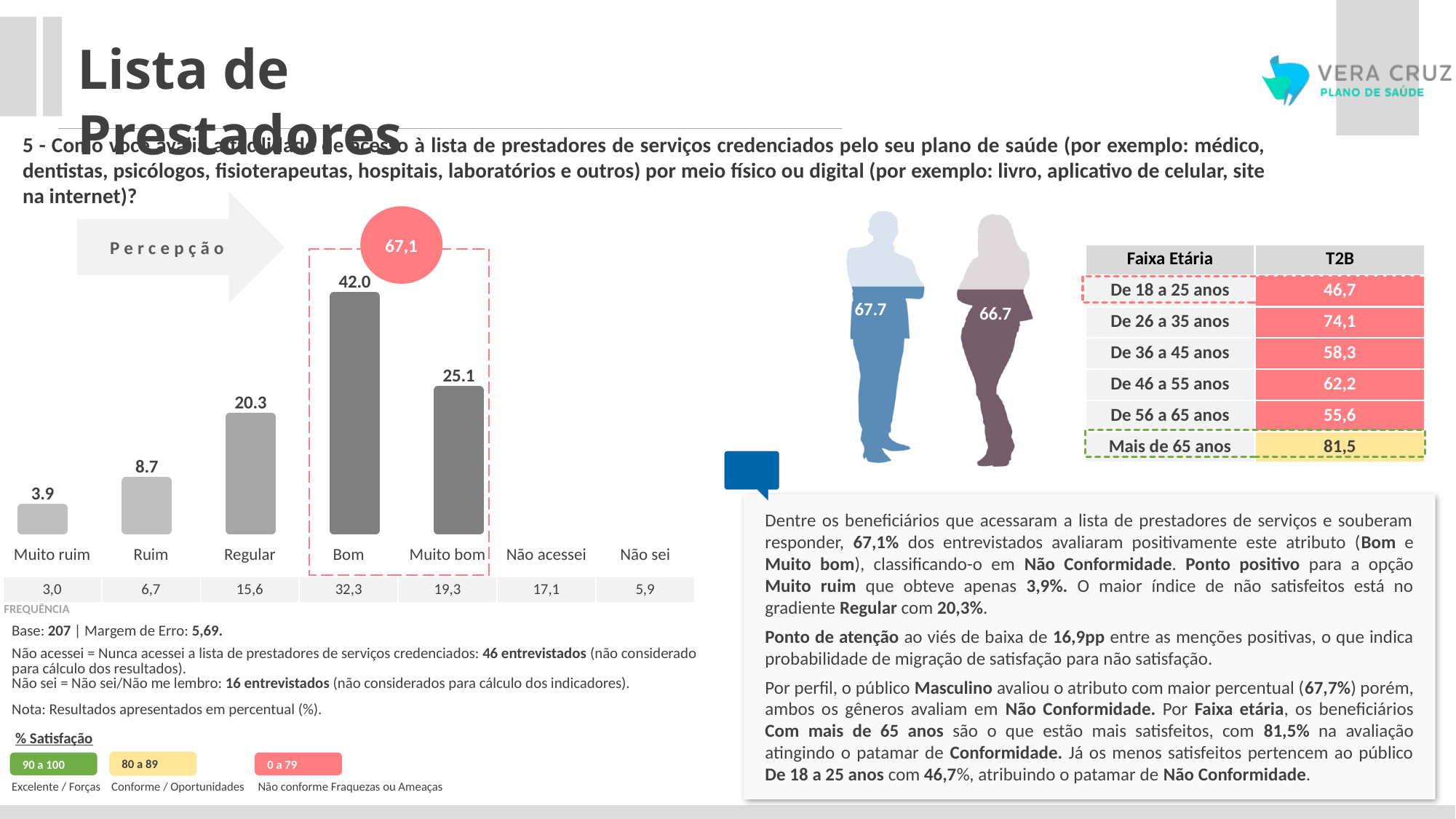
In the Faixa Etária table, which age group has the lowest T2B value? De 18 a 25 anos In the bar chart, which is larger, the value for Ruim or the value for Regular? Regular In the bar chart, which category has the highest value? Bom In the bar chart, what is the value for Bom? 42.0 In the bar chart, what is the combined value shown in the red circle for Bom and Muito bom? 67,1 In the bar chart, which category has the lowest plotted value? Muito ruim In the bar chart, what is the value for Muito ruim? 3.9 What is the value shown for the male figure on the slide? 67.7 In the bar chart, what is the value for Regular? 20.3 In the bar chart, what is the difference between the values for Bom and Muito bom? 16.9 What type of chart is used to show the Percepção results? Bar chart In the Faixa Etária table, what is the T2B value for Mais de 65 anos? 81,5